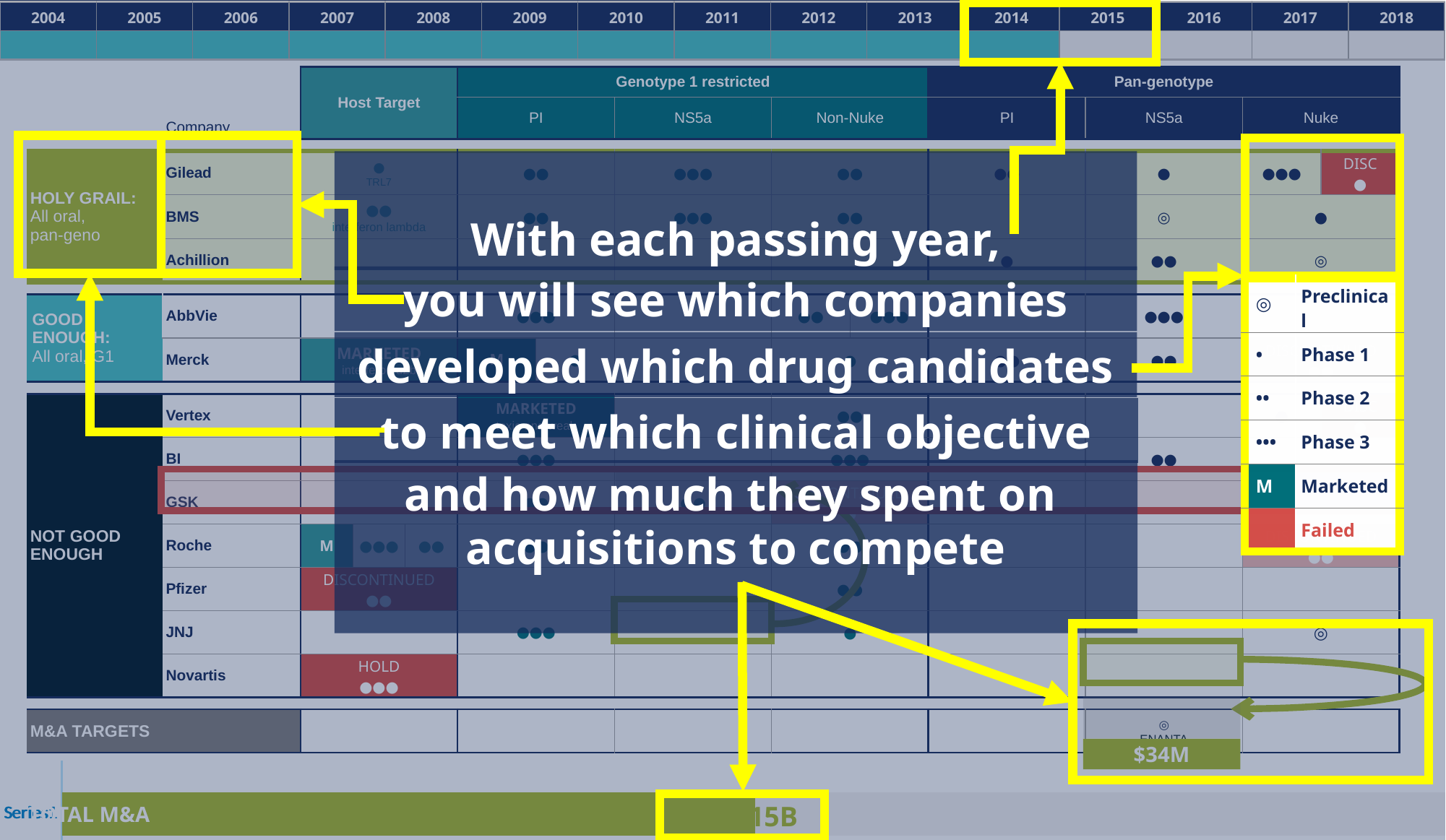
What is the first year shown on the timeline at the top of the slide? 2004 How many years are shown along the timeline at the top of the slide? 15 What is the name of the series shown in the legend of the TOTAL M&A chart at the bottom? Series1 Which two years on the top timeline are outlined with a yellow box? 2014 and 2015 What value is shown for the ENANTA M&A target in the bottom-right of the table? $34M What kind of chart is the TOTAL M&A chart at the bottom of the slide? bar chart How many companies are listed in the Company column of the table? 12 What is the last year shown on the timeline at the top of the slide? 2018